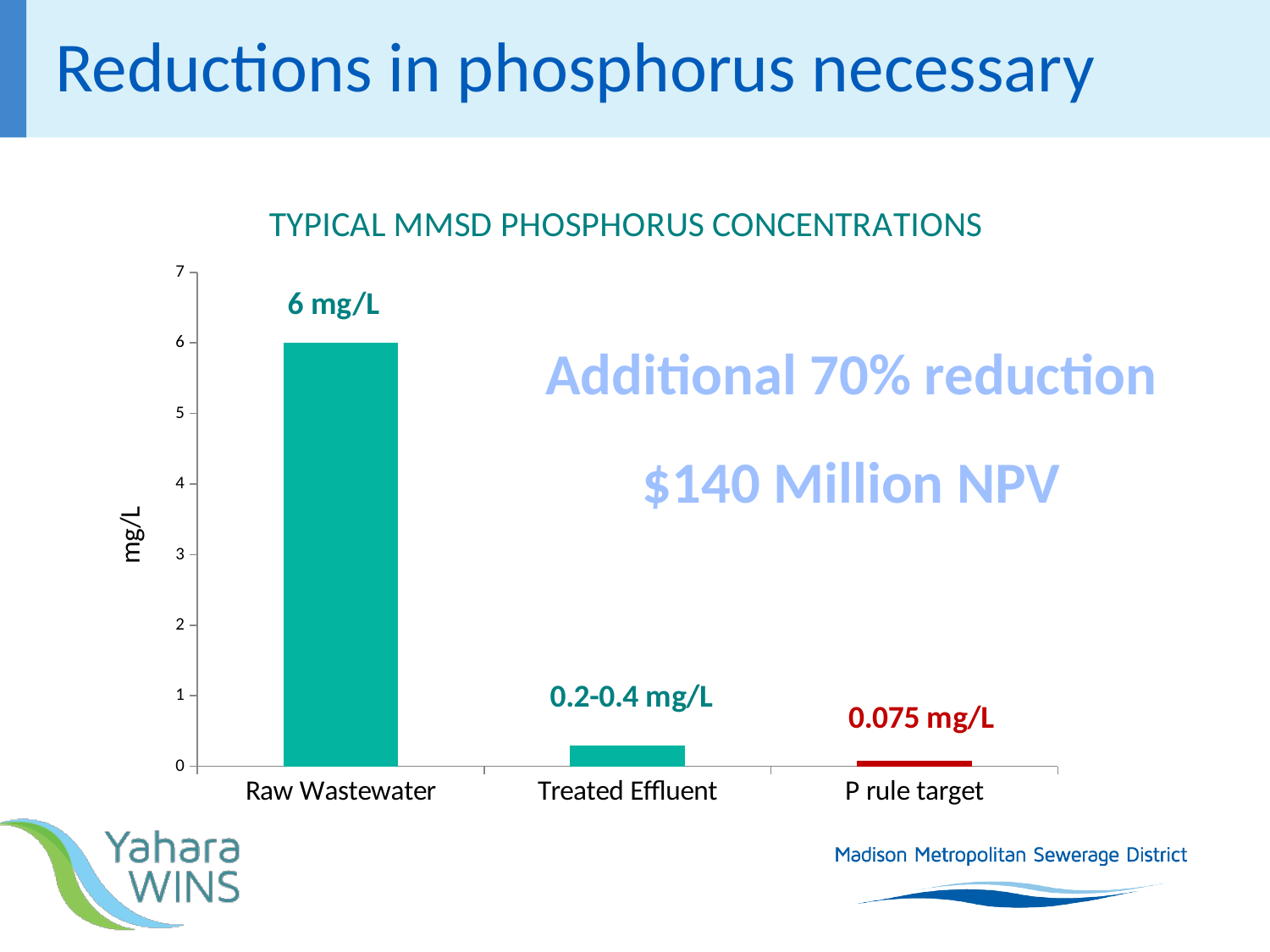
What is the title of the chart? TYPICAL MMSD PHOSPHORUS CONCENTRATIONS What is the labelled value for P rule target? 0.075 mg/L Which category has the highest phosphorus concentration? Raw Wastewater Is the value for Raw Wastewater greater or less than 5? greater What is the labelled value for Treated Effluent? 0.2-0.4 mg/L What kind of chart is shown on the slide? bar chart What is the labelled value for Raw Wastewater? 6 mg/L How many categories are shown on the x axis of the chart? 3 Which category has the lowest phosphorus concentration? P rule target What is the label on the y axis of the chart? mg/L Is the value for Treated Effluent greater or less than 1? less Which is larger, the value for Treated Effluent or the value for P rule target? Treated Effluent